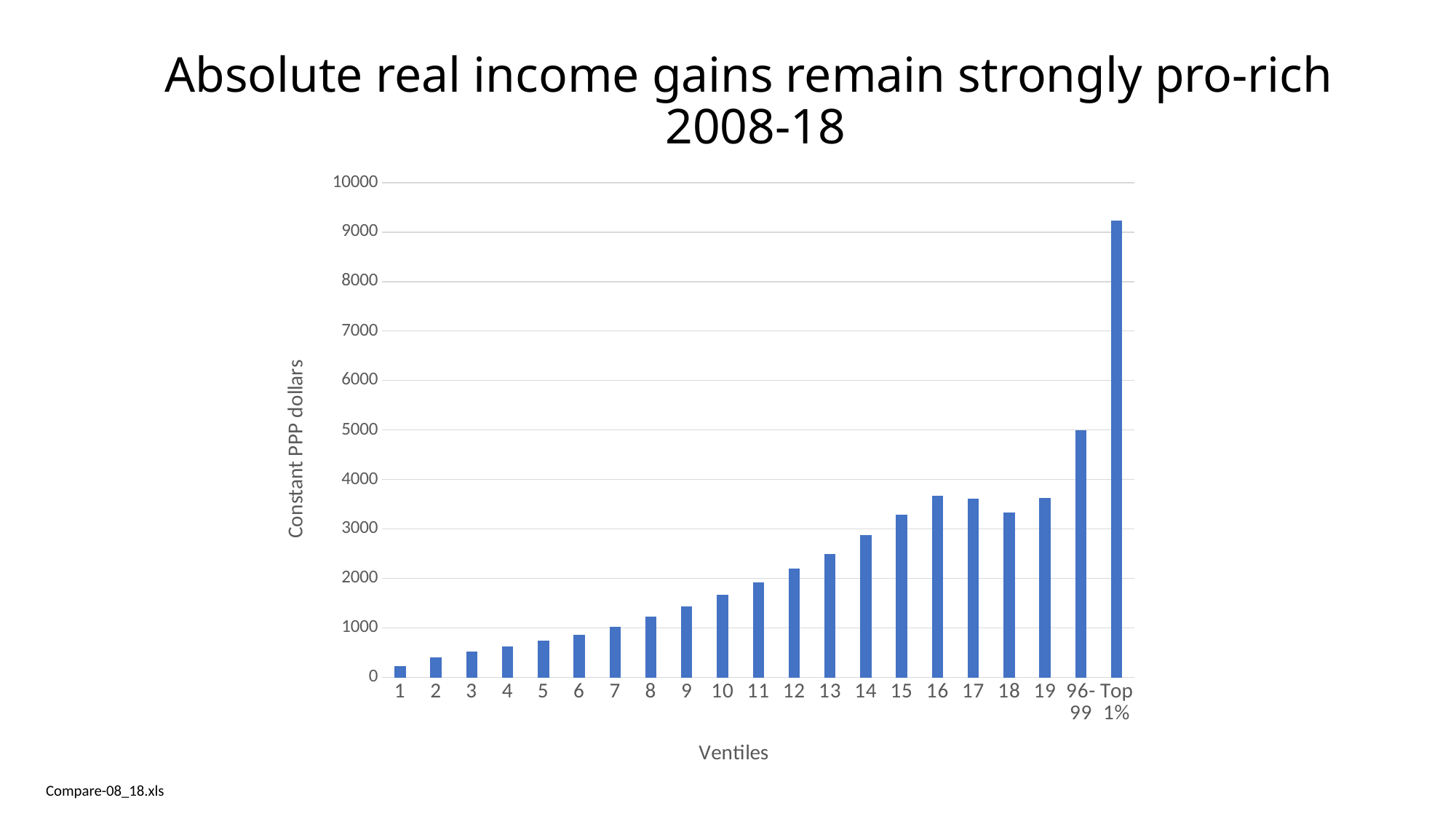
What kind of chart is shown on the slide? bar chart How many categories are shown on the x axis? 21 Is the value for ventile 1 greater or less than 1000? less Which category has the lowest value? 1 Is the value for ventile 13 greater or less than 3000? less What is the label of the y axis? Constant PPP dollars Which category has the highest value? Top 1% Is the value for Top 1% greater or less than 8000? greater Which is larger, the value for 96-99 or the value for Top 1%? Top 1% Do the values generally rise or fall from ventile 1 to Top 1%? rise